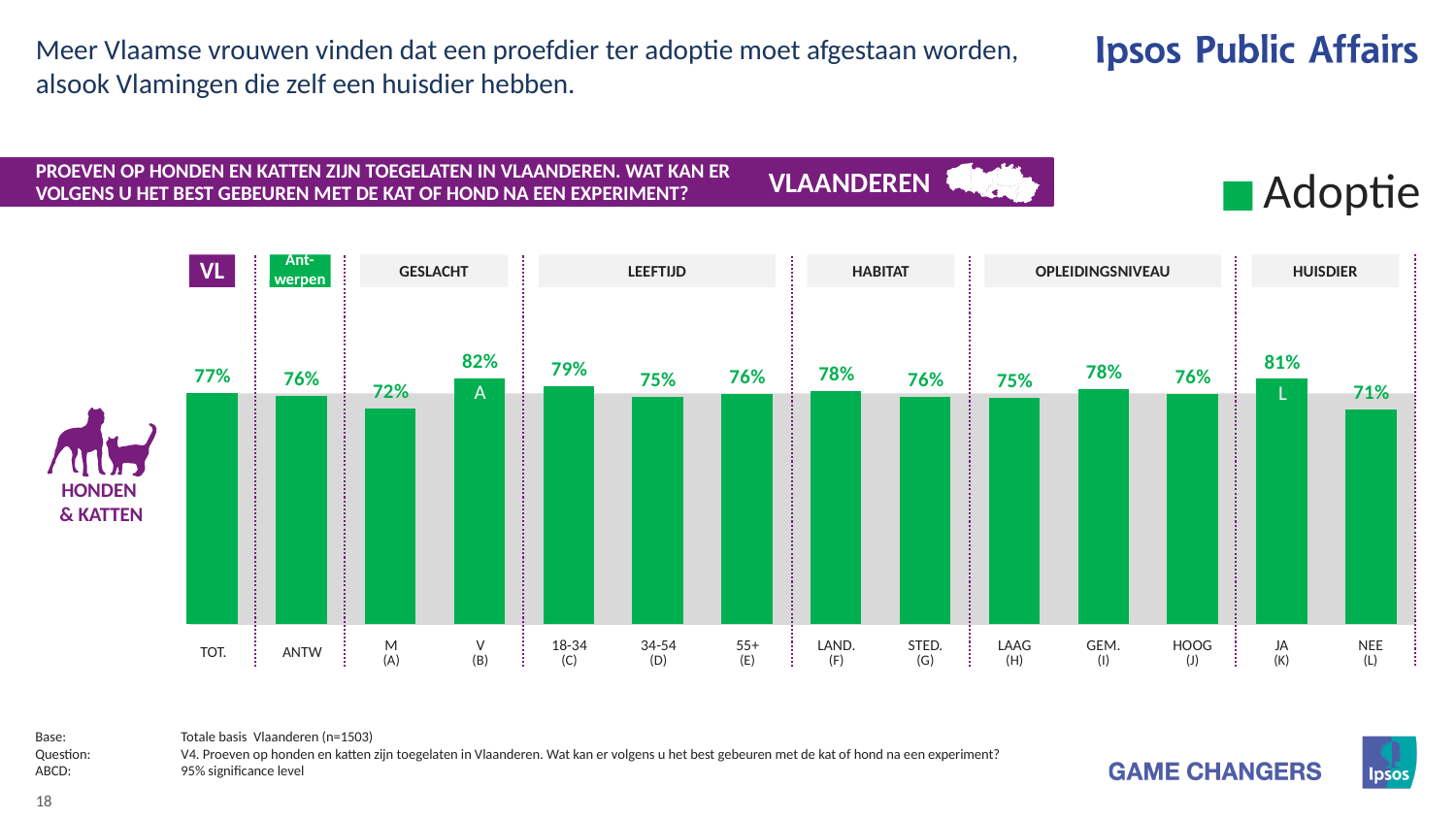
Which category has the highest value in the chart? V (women), 82% How many series does the legend list? 1 What is the value for respondents who do not have a pet (NEE)? 71% What is the value for respondents aged 18-34? 79% What is the difference between the values for women (V) and men (M)? 10 percentage points Which category has the lowest value in the chart? NEE, 71% Which is larger, the value for LAND. or the value for STED.? LAND. What percentage of Flemish women (V) say the animal should be put up for adoption? 82% How many bars are shown in the chart? 14 What type of chart is shown on the slide? Bar chart What is the difference between pet owners (JA) and non-owners (NEE)? 10 percentage points What is the value for the total (TOT.) bar? 77%